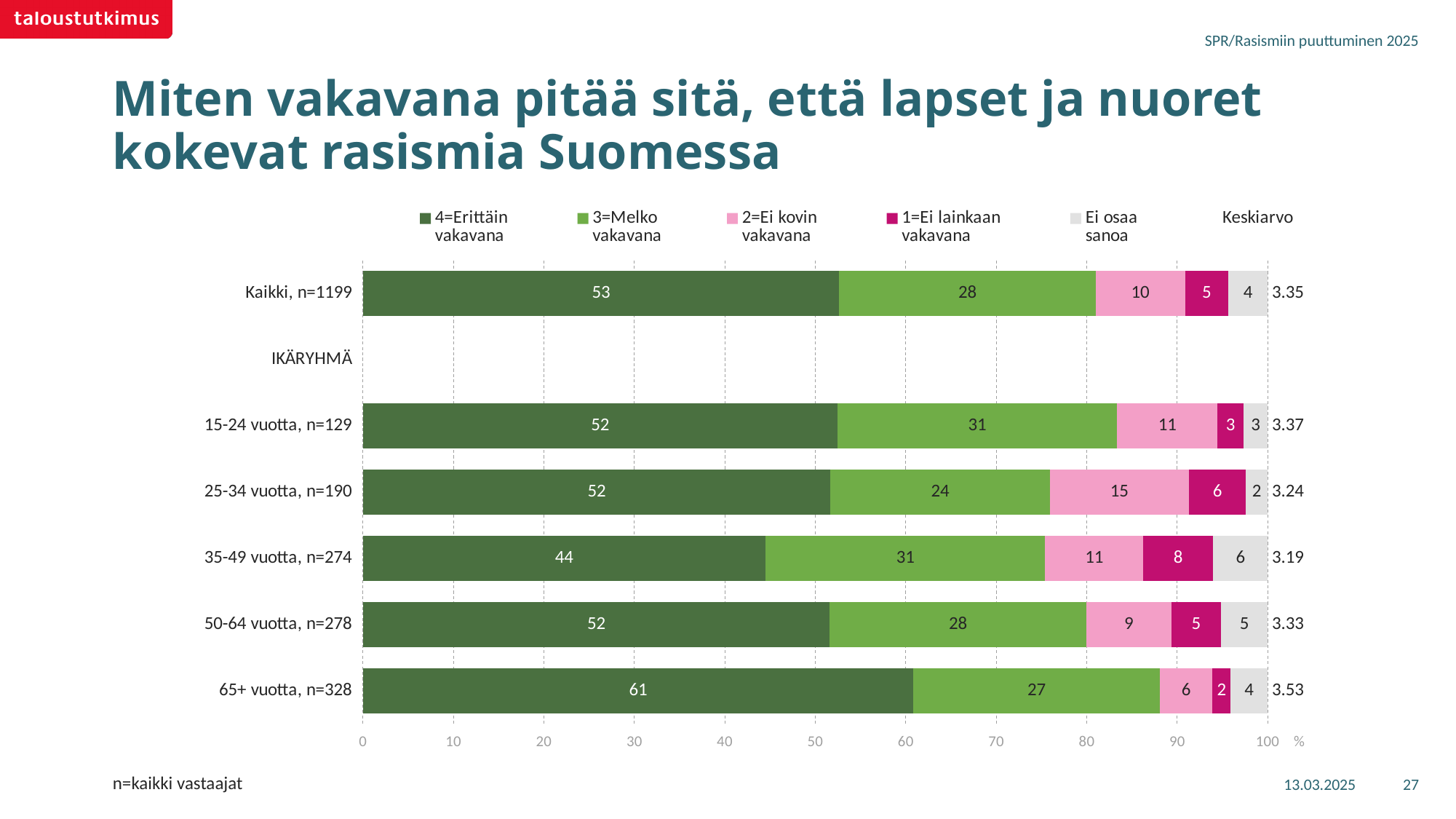
What is the Keskiarvo value for the Kaikki, n=1199 row? 3.35 Which age group has the lowest share of 4=Erittäin vakavana responses? 35-49 vuotta What percentage of the 25-34 vuotta group answered 2=Ei kovin vakavana? 15 Which group has a larger share of 3=Melko vakavana responses, 15-24 vuotta or 25-34 vuotta? 15-24 vuotta What percentage of the 65+ vuotta group answered 4=Erittäin vakavana? 61 What is the difference in the 4=Erittäin vakavana share between the 65+ vuotta group and the 35-49 vuotta group? 17 What type of chart is shown on the slide? Stacked bar chart Which age group has the highest share of 4=Erittäin vakavana responses? 65+ vuotta How many bars are plotted in the chart? 6 What is the Keskiarvo (mean) for the 35-49 vuotta group? 3.19 Which age group has the highest Keskiarvo value? 65+ vuotta What is the total of the segments in the Kaikki, n=1199 bar? 100